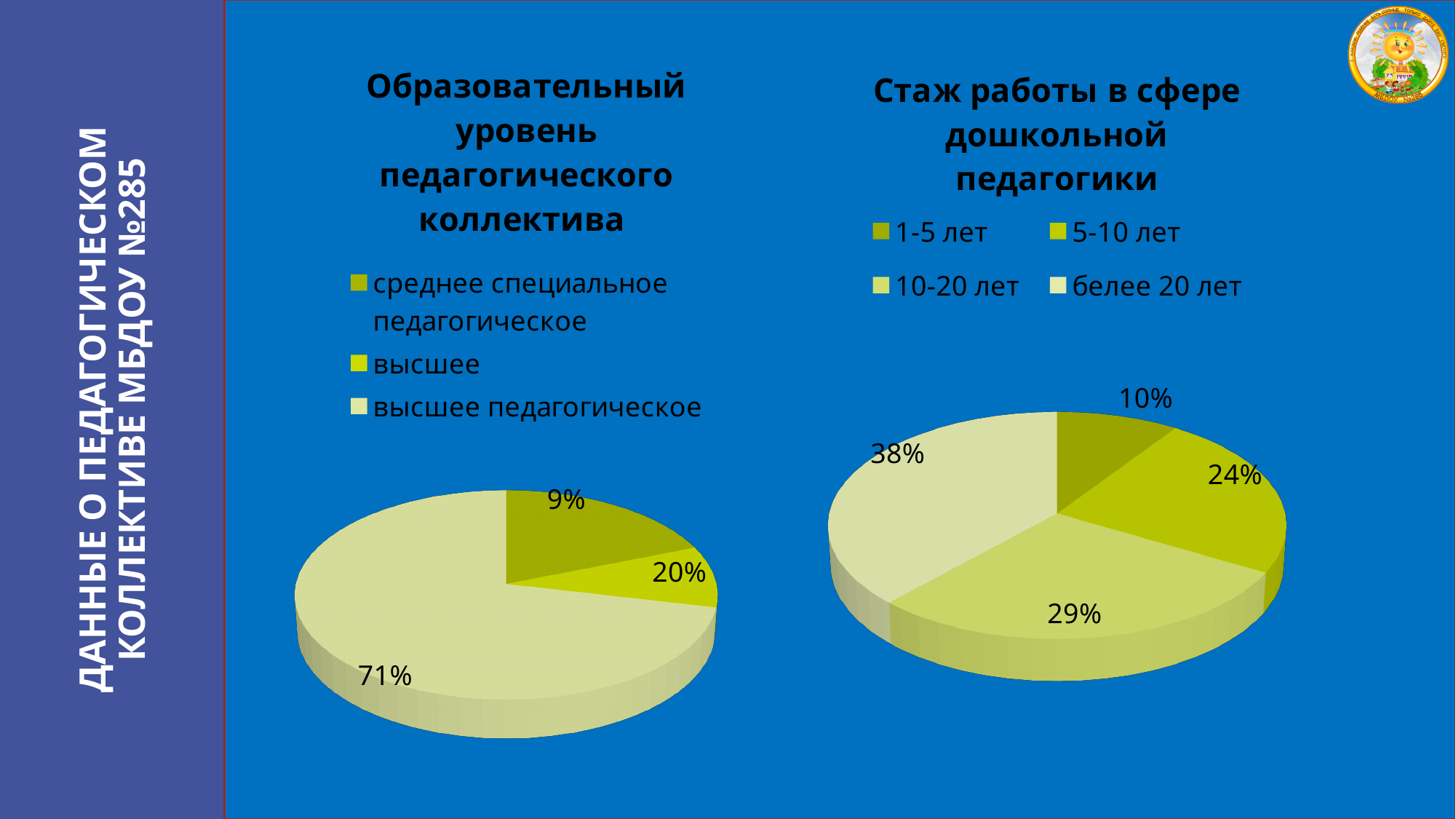
In the right chart (Стаж работы в сфере дошкольной педагогики), which experience group has the largest slice? белее 20 лет In the left chart (Образовательный уровень педагогического коллектива), what share of the staff has высшее педагогическое education? 71% What type of chart is used for the right chart (Стаж работы в сфере дошкольной педагогики)? Pie chart In the right chart (Стаж работы в сфере дошкольной педагогики), which is larger: the 5-10 лет slice or the 10-20 лет slice? 10-20 лет How many categories does the legend of the left chart (Образовательный уровень педагогического коллектива) list? 3 In the left chart (Образовательный уровень педагогического коллектива), what is the difference between the высшее педагогическое and высшее shares? 51% In the left chart (Образовательный уровень педагогического коллектива), which category has the largest slice? высшее педагогическое In the right chart (Стаж работы в сфере дошкольной педагогики), what share of the staff has 1-5 лет of experience? 10% In the left chart (Образовательный уровень педагогического коллектива), what share of the staff has среднее специальное педагогическое education? 9% How many categories does the legend of the right chart (Стаж работы в сфере дошкольной педагогики) list? 4 In the right chart (Стаж работы в сфере дошкольной педагогики), what share of the staff has 10-20 лет of experience? 29%